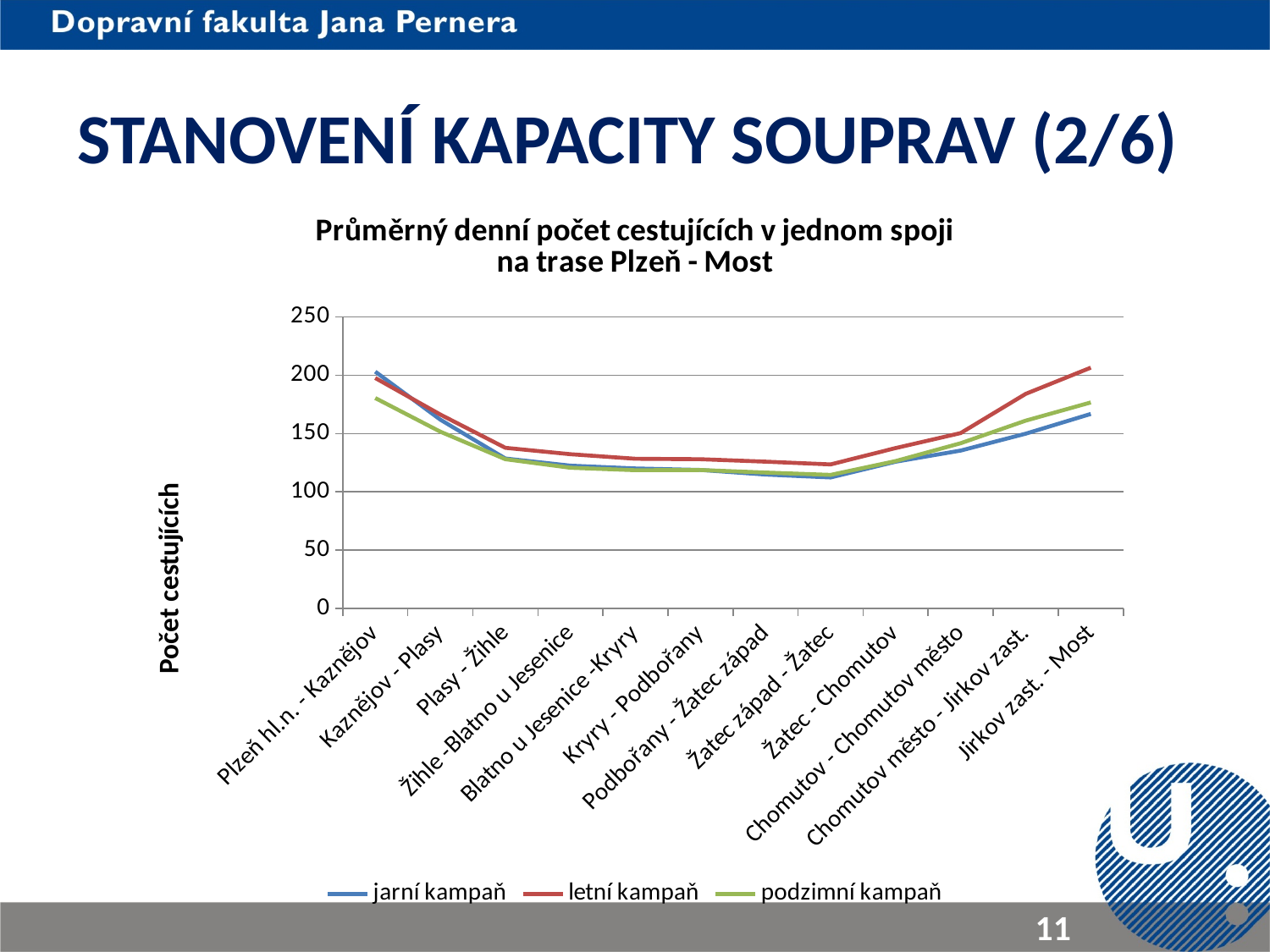
What kind of chart is shown on the slide? line chart What is the label of the vertical axis? Počet cestujících What is the title of the chart? Průměrný denní počet cestujících v jednom spoji na trase Plzeň - Most Is the value of jarní kampaň for Plzeň hl.n. - Kaznějov greater or less than 150? greater Is the value of podzimní kampaň for Plzeň hl.n. - Kaznějov greater or less than 150? greater Which series has the lowest value for Plzeň hl.n. - Kaznějov? podzimní kampaň How many series does the legend list? 3 Which series has the highest value for Jirkov zast. - Most? letní kampaň Is the value of letní kampaň for Žatec západ - Žatec greater or less than 150? less Do the values of letní kampaň rise or fall from Žatec - Chomutov to Jirkov zast. - Most? rise How many route segments (categories) are shown on the x axis? 12 For jarní kampaň, which is larger: the value for Plzeň hl.n. - Kaznějov or the value for Jirkov zast. - Most? Plzeň hl.n. - Kaznějov